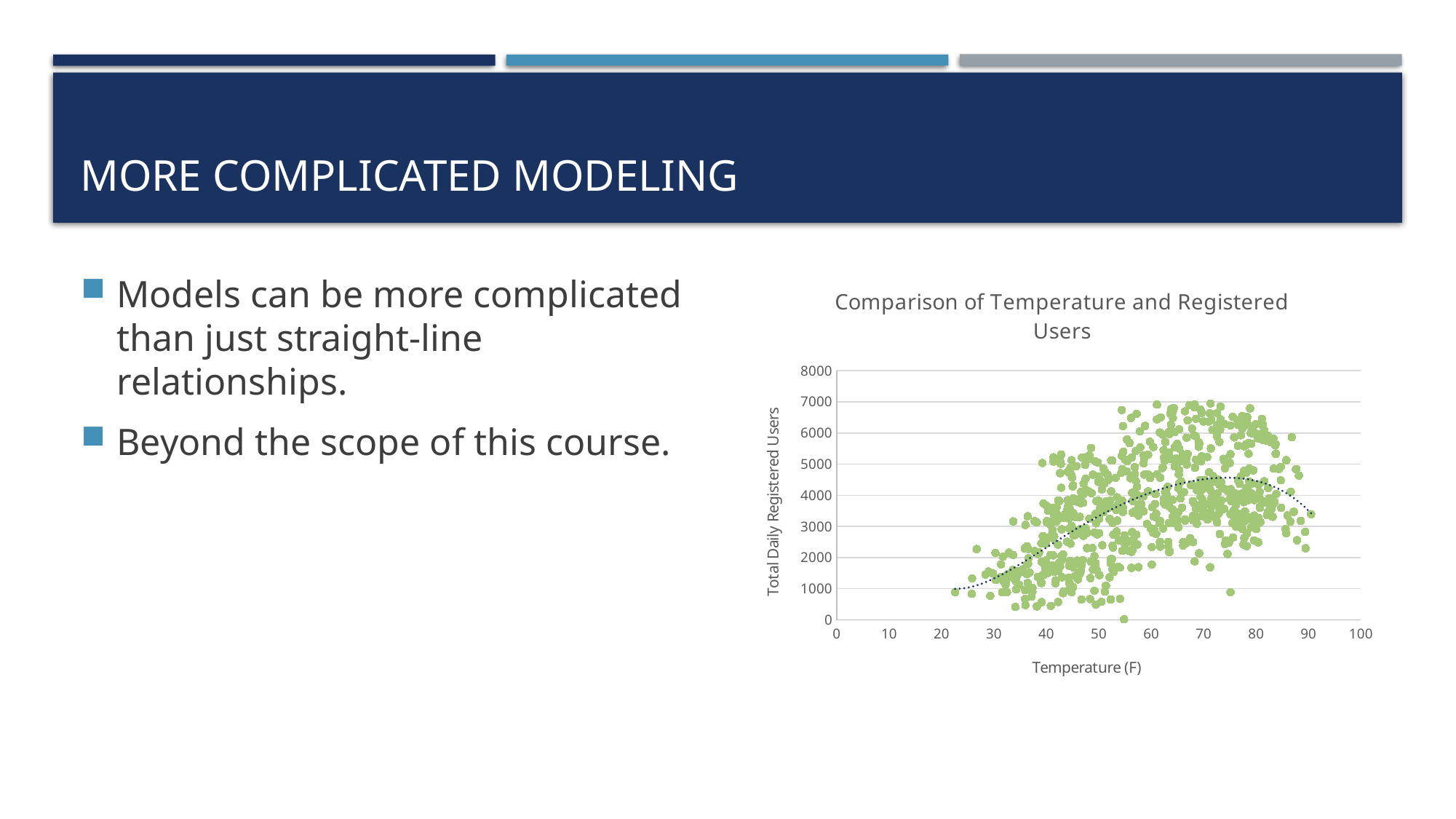
Is the temperature of the leftmost point greater or less than 10? greater Do the registered users generally rise or fall as temperature increases from 20 to 70 degrees? rise Are any points plotted above 8000 registered users? no Is the lowest temperature plotted greater or less than 30? less Does the trendline rise or fall as temperature increases from 80 to 90 degrees? fall What kind of chart is shown on the slide? scatter chart Is the fitted trendline on the chart straight or curved? curved What is the title of the chart? Comparison of Temperature and Registered Users